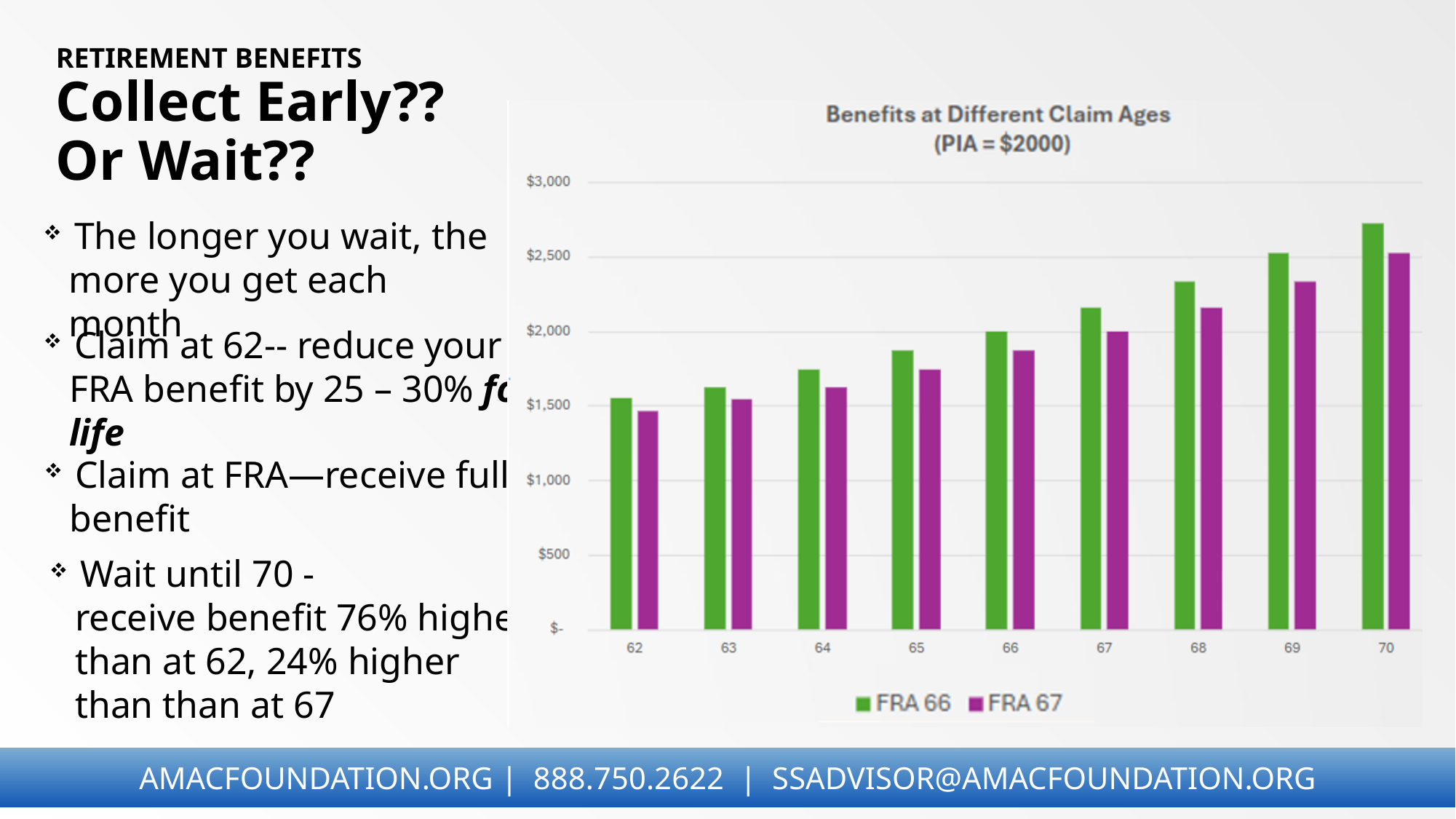
How many claim ages are shown on the x axis of the chart? 9 Which colour represents the FRA 67 series in the chart? purple What is the title of the chart? Benefits at Different Claim Ages (PIA = $2000) Do the benefit values rise or fall as the claim age increases from 62 to 70? rise What type of chart is shown on the slide? bar chart Is the FRA 67 benefit at claim age 69 greater or less than $2,500? less Is the FRA 66 benefit at claim age 70 greater or less than $2,500? greater Is the FRA 67 benefit at claim age 62 greater or less than $1,500? less Which claim age has the lowest FRA 67 benefit? 62 Which claim age has the highest FRA 66 benefit? 70 How many series does the chart legend list? 2 At claim age 65, which series has the larger benefit, FRA 66 or FRA 67? FRA 66